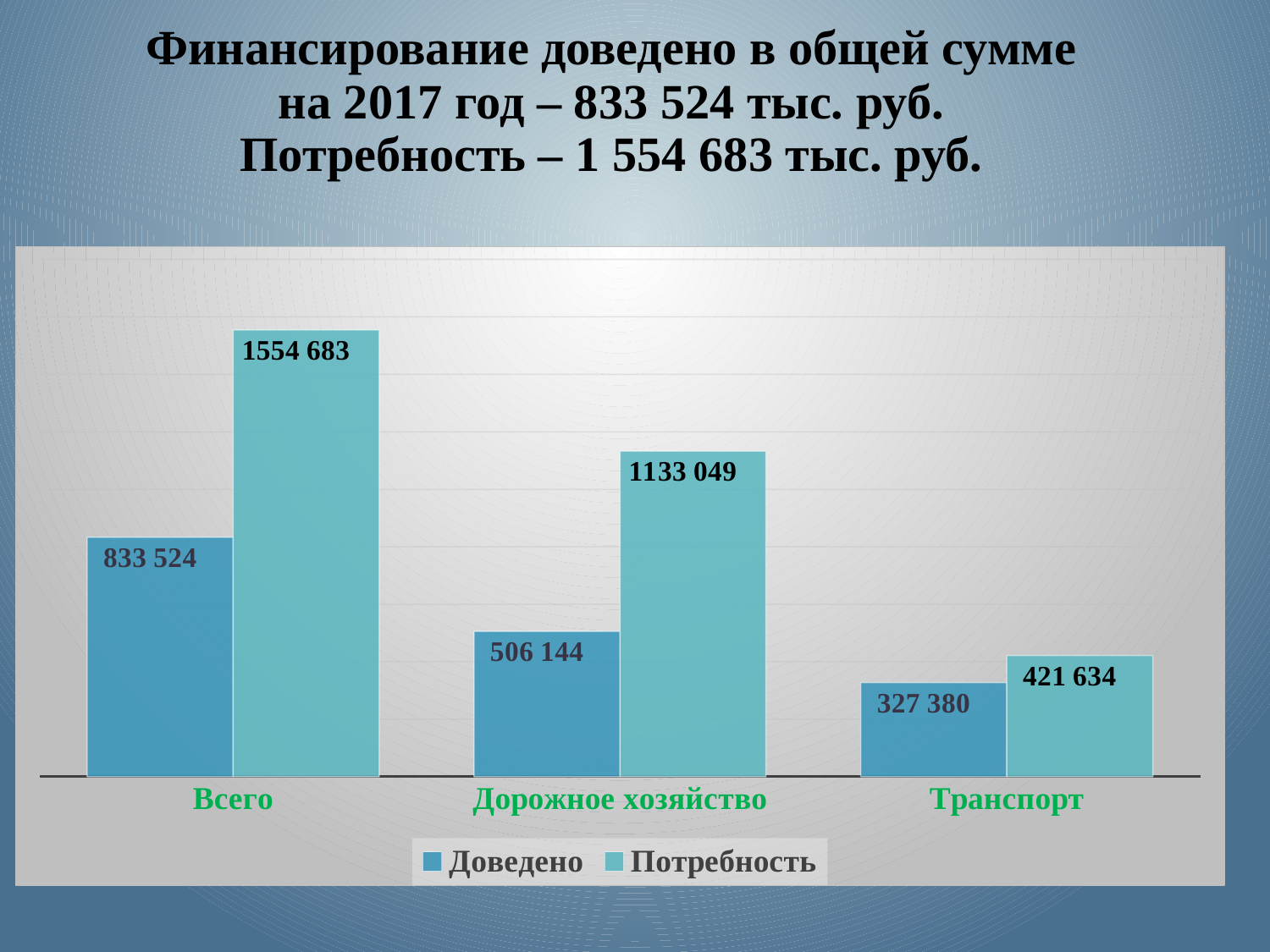
What is the difference between Потребность and Доведено for Транспорт? 94 254 Which category has the highest Потребность value? Всего Which is larger for Дорожное хозяйство: Доведено or Потребность? Потребность What is the value of Доведено for Транспорт? 327 380 What kind of chart is shown on the slide? Bar chart What is the value of Потребность for Транспорт? 421 634 How many categories are shown on the x axis? 3 What is the difference between Потребность and Доведено for Всего? 721 159 What is the value of Потребность for Дорожное хозяйство? 1133 049 What is the value of Доведено for Всего? 833 524 How many series does the legend list? 2 Which category has the lowest Доведено value? Транспорт